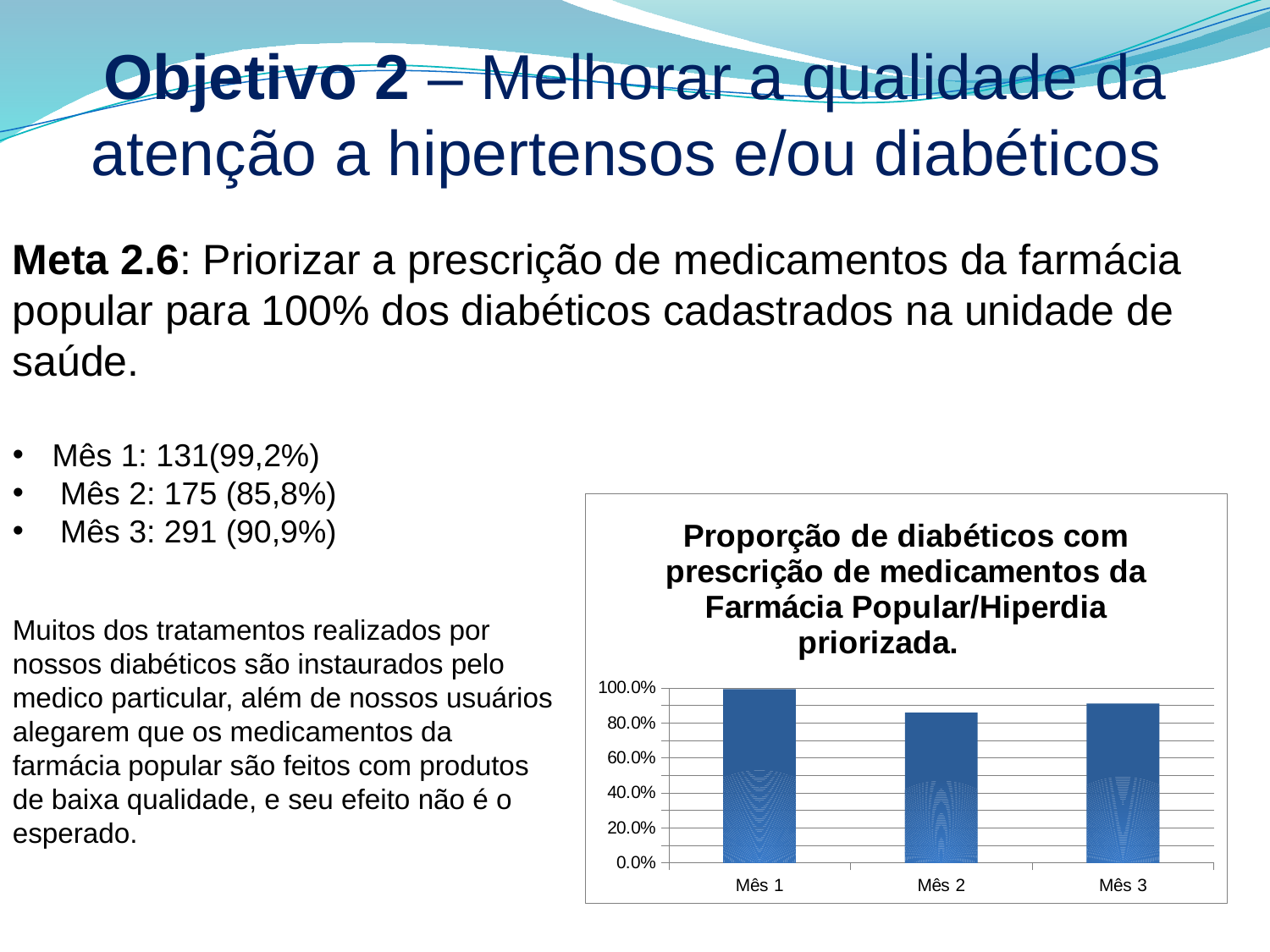
What kind of chart is shown on the slide? bar chart Is the value for Mês 2 greater or less than 100.0%? less Which is larger, the value for Mês 1 or the value for Mês 3? Mês 1 Which month has the highest bar in the chart? Mês 1 Which month has the lowest bar in the chart? Mês 2 Is the value for Mês 1 greater or less than 80.0%? greater How many categories are shown on the x axis of the chart? 3 What is the highest value shown on the y axis of the chart? 100.0% Is the value for Mês 3 greater or less than 80.0%? greater What is the title of the chart? Proporção de diabéticos com prescrição de medicamentos da Farmácia Popular/Hiperdia priorizada. Which is larger, the value for Mês 2 or the value for Mês 3? Mês 3